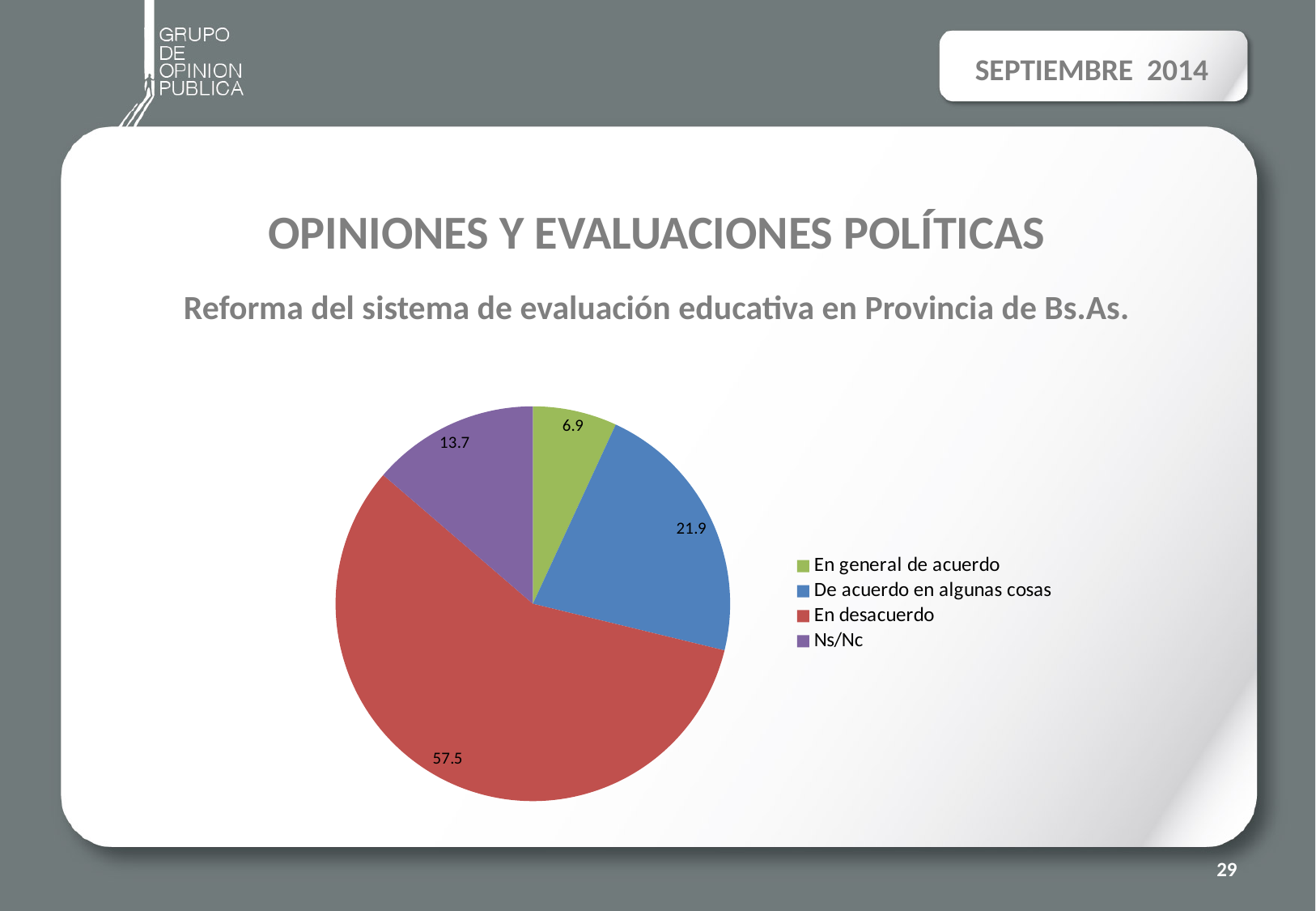
Which is larger, the value for "Ns/Nc" or the value for "En general de acuerdo"? Ns/Nc What is the difference between the values for "En desacuerdo" and "De acuerdo en algunas cosas"? 35.6 What is the value for "De acuerdo en algunas cosas"? 21.9 What is the subtitle of the chart on the slide? Reforma del sistema de evaluación educativa en Provincia de Bs.As. What is the value for "En desacuerdo"? 57.5 What kind of chart is shown on the slide? Pie chart What colour is the slice for "En desacuerdo"? Red What is the value for "Ns/Nc"? 13.7 How many categories does the pie chart show? 4 What is the value for "En general de acuerdo"? 6.9 Which category has the largest slice of the pie? En desacuerdo Which category has the smallest slice of the pie? En general de acuerdo